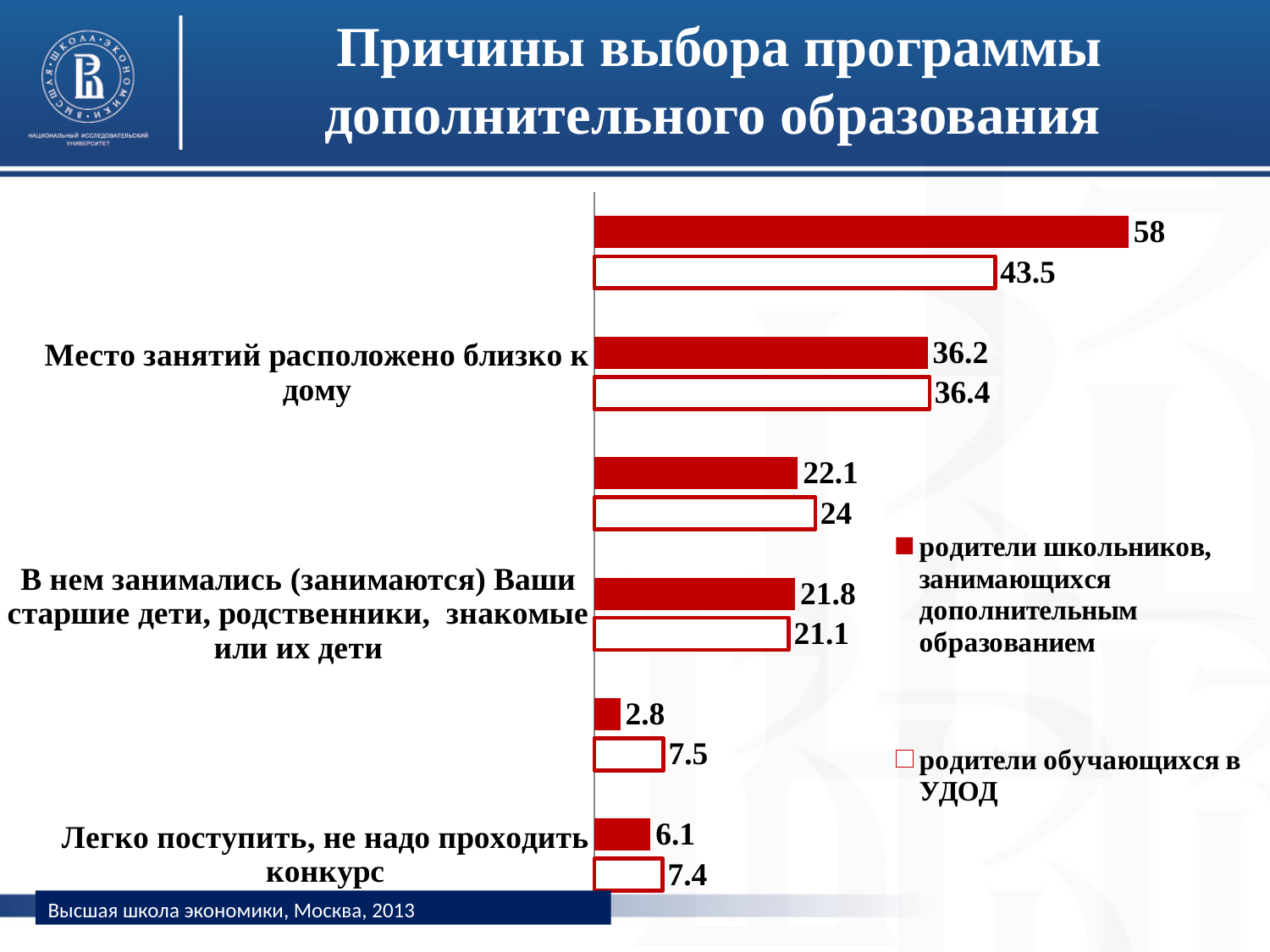
What is the value for "Легко поступить, не надо проходить конкурс" for the series "родители школьников, занимающихся дополнительным образованием"? 6.1 What is the value for "Место занятий расположено близко к дому" for the series "родители школьников, занимающихся дополнительным образованием"? 36.2 How many series does the legend list? 2 For "В нем занимались (занимаются) Ваши старшие дети, родственники, знакомые или их дети", which series has the larger value: "родители школьников, занимающихся дополнительным образованием" or "родители обучающихся в УДОД"? родители школьников, занимающихся дополнительным образованием What is the difference between the two series' values for "Легко поступить, не надо проходить конкурс"? 1.3 What is the value for "Легко поступить, не надо проходить конкурс" for the series "родители обучающихся в УДОД"? 7.4 What is the value for "Место занятий расположено близко к дому" for the series "родители обучающихся в УДОД"? 36.4 What kind of chart is shown on the slide? bar chart What is the value for "В нем занимались (занимаются) Ваши старшие дети, родственники, знакомые или их дети" for the series "родители школьников, занимающихся дополнительным образованием"? 21.8 What is the value for "В нем занимались (занимаются) Ваши старшие дети, родственники, знакомые или их дети" for the series "родители обучающихся в УДОД"? 21.1 Among the labelled categories, which has the lowest value for the series "родители школьников, занимающихся дополнительным образованием"? Легко поступить, не надо проходить конкурс What is the largest value printed on the chart? 58